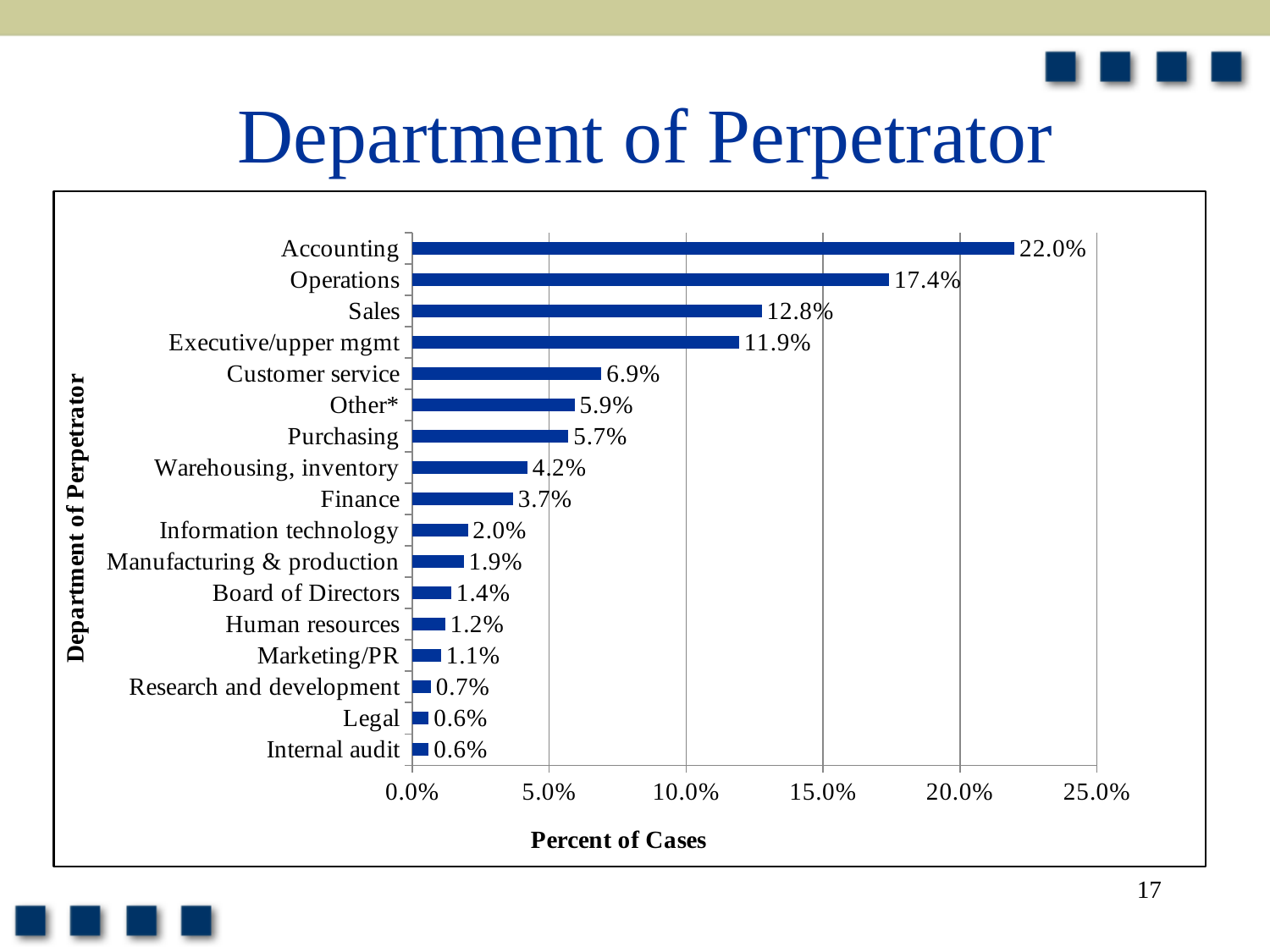
What percent of cases is shown for Executive/upper mgmt? 11.9% Which department has the highest percent of cases? Accounting What percent of cases is shown for Accounting? 22.0% What is the label on the horizontal axis of the chart? Percent of Cases What kind of chart is shown on the slide? Bar chart What percent of cases is shown for Human resources? 1.2% How many departments are listed in the chart? 17 What is the difference in percent of cases between Accounting and Operations? 4.6% Which has a higher percent of cases, Purchasing or Finance? Purchasing What percent of cases is shown for Warehousing, inventory? 4.2% Is the value for Operations greater or less than 15.0%? greater What is the difference in percent of cases between Sales and Customer service? 5.9%